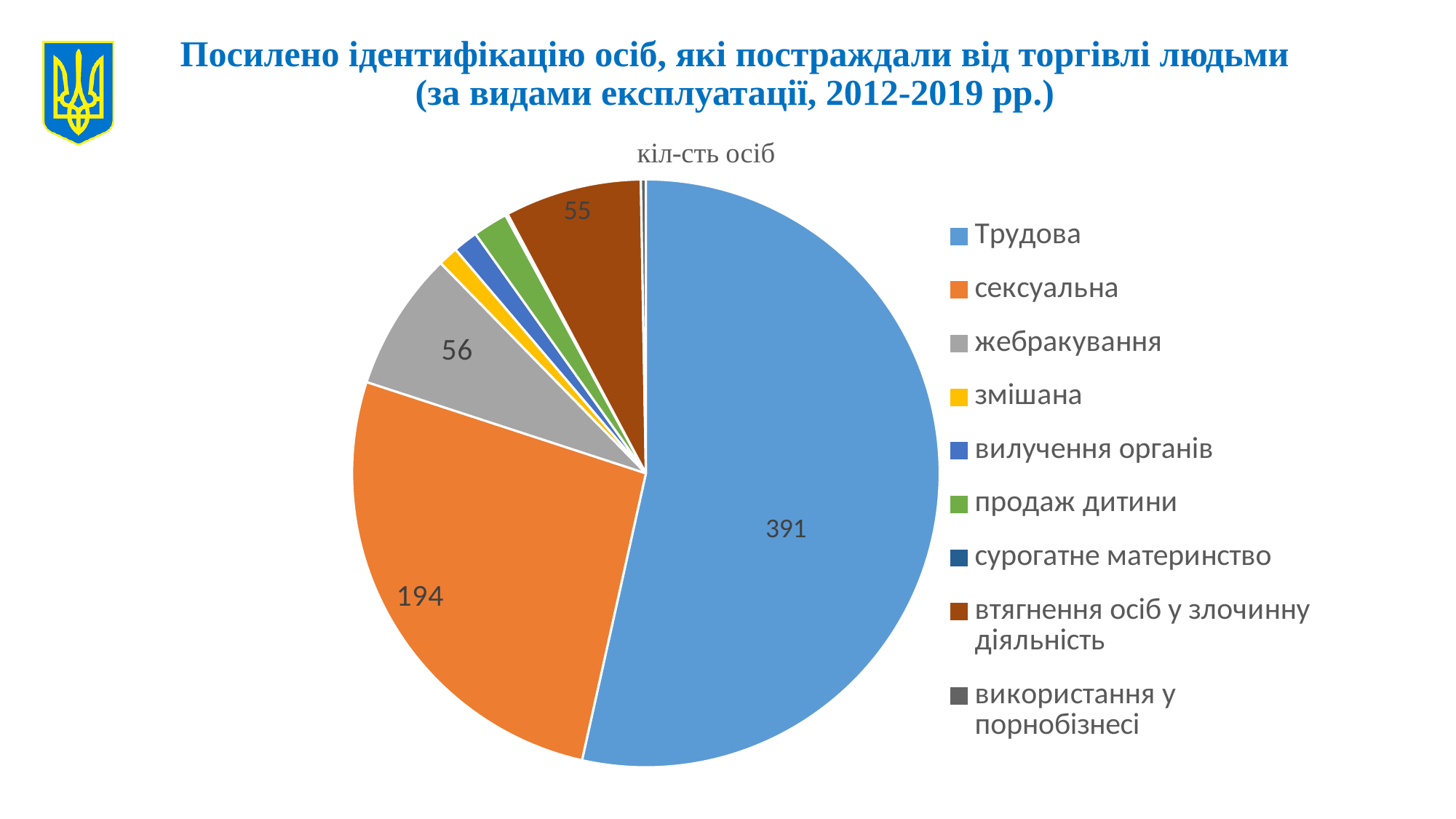
What is the difference between the values for Трудова and сексуальна? 197 What is the value for жебракування? 56 Which is larger, the slice for жебракування or the slice for змішана? жебракування What colour is the slice for сексуальна? orange What is the value for втягнення осіб у злочинну діяльність? 55 Which category has the largest slice of the pie? Трудова What kind of chart is shown on the slide? pie chart What is the title of the chart? кіл-сть осіб How many categories does the legend list? 9 What is the value for Трудова? 391 Which is larger, the value for сексуальна or the value for жебракування? сексуальна What is the value for сексуальна? 194